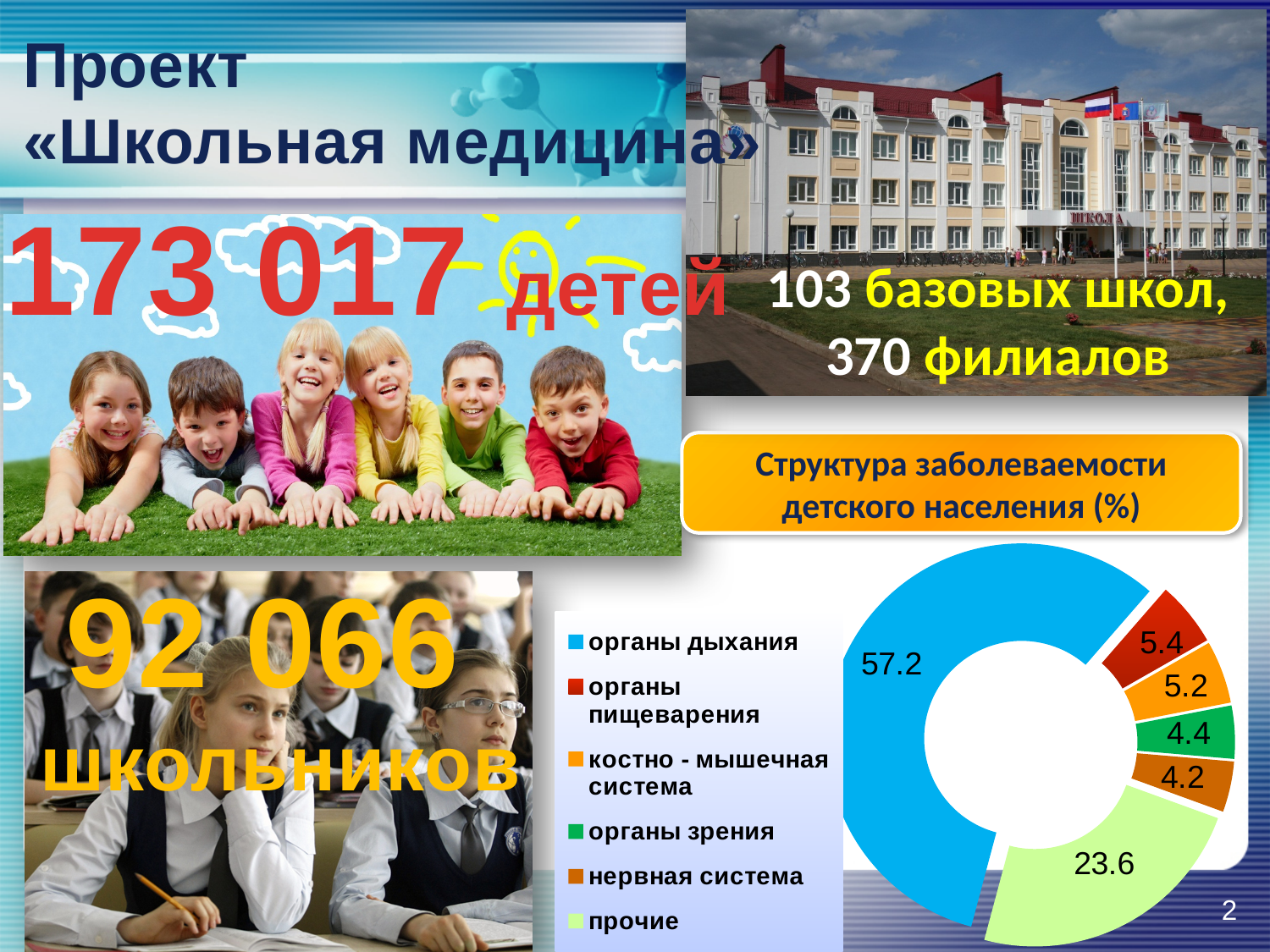
In the chart «Структура заболеваемости детского населения (%)», what is the value for «нервная система»? 4.2 How many categories does the legend of the chart «Структура заболеваемости детского населения (%)» list? 6 In the chart «Структура заболеваемости детского населения (%)», which category has the largest share? органы дыхания In the chart «Структура заболеваемости детского населения (%)», what is the difference between «органы дыхания» and «прочие»? 33.6 What type of chart is shown under the title «Структура заболеваемости детского населения (%)»? Pie (doughnut) chart In the chart «Структура заболеваемости детского населения (%)», what colour is the slice for «органы дыхания»? Blue In the chart «Структура заболеваемости детского населения (%)», what is the value for «органы зрения»? 4.4 In the chart «Структура заболеваемости детского населения (%)», what is the difference between «органы пищеварения» and «костно - мышечная система»? 0.2 In the chart «Структура заболеваемости детского населения (%)», what is the value for «органы дыхания»? 57.2 In the chart «Структура заболеваемости детского населения (%)», which category has the smallest share? нервная система In the chart «Структура заболеваемости детского населения (%)», what is the value for «прочие»? 23.6 In the chart «Структура заболеваемости детского населения (%)», which is larger: «органы пищеварения» or «органы зрения»? органы пищеварения